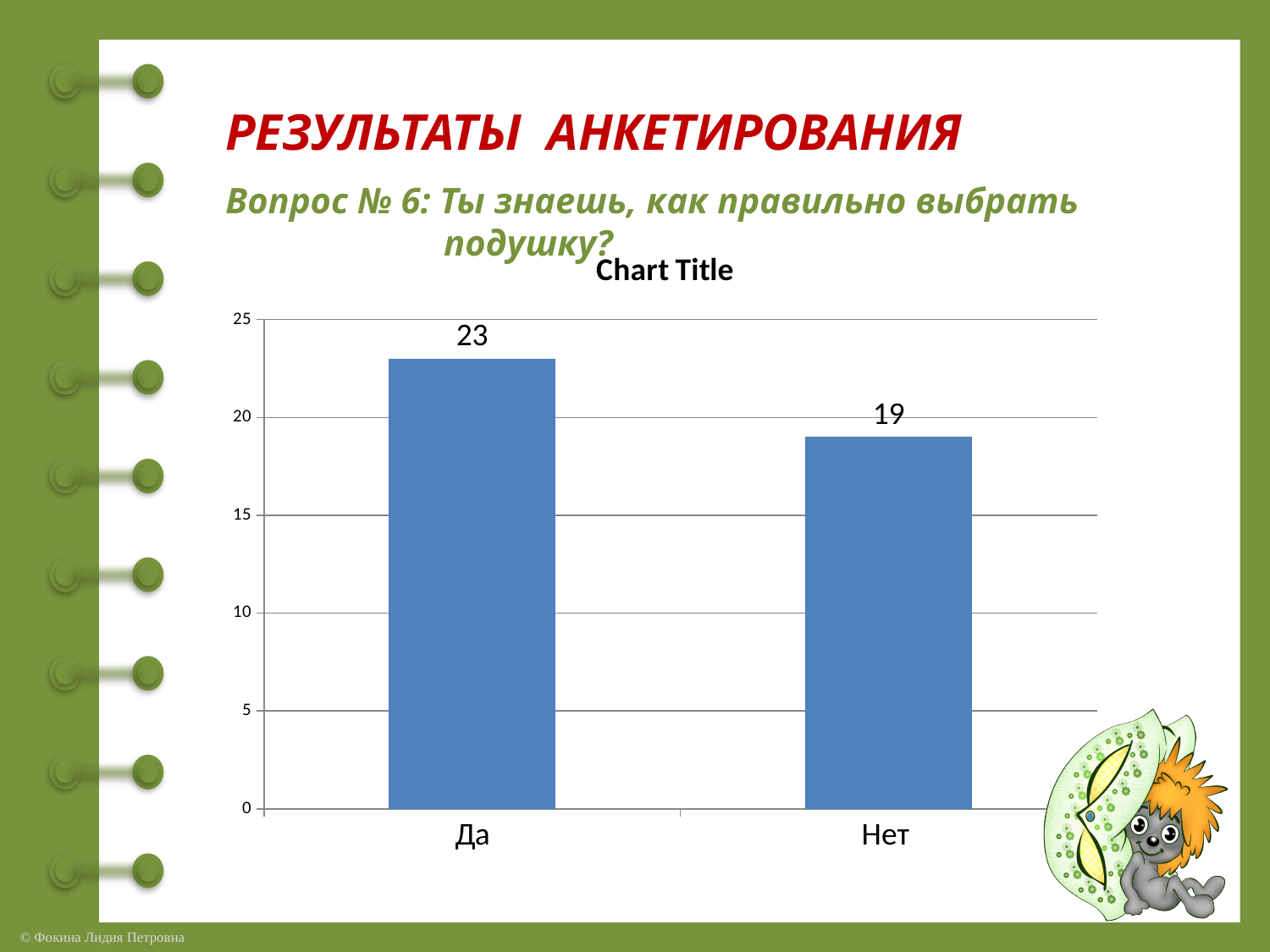
Is the value for "Да" greater or less than 20? greater What kind of chart is shown on the slide? bar chart What is the difference between the values for "Да" and "Нет"? 4 What is the value for "Да"? 23 Which is larger, the value for "Да" or the value for "Нет"? Да What is the title printed above the chart? Chart Title Which category has the highest value? Да What is the highest value shown on the vertical axis? 25 Is the value for "Нет" greater or less than 20? less What is the value for "Нет"? 19 Which category has the lowest value? Нет How many categories are shown on the x axis? 2